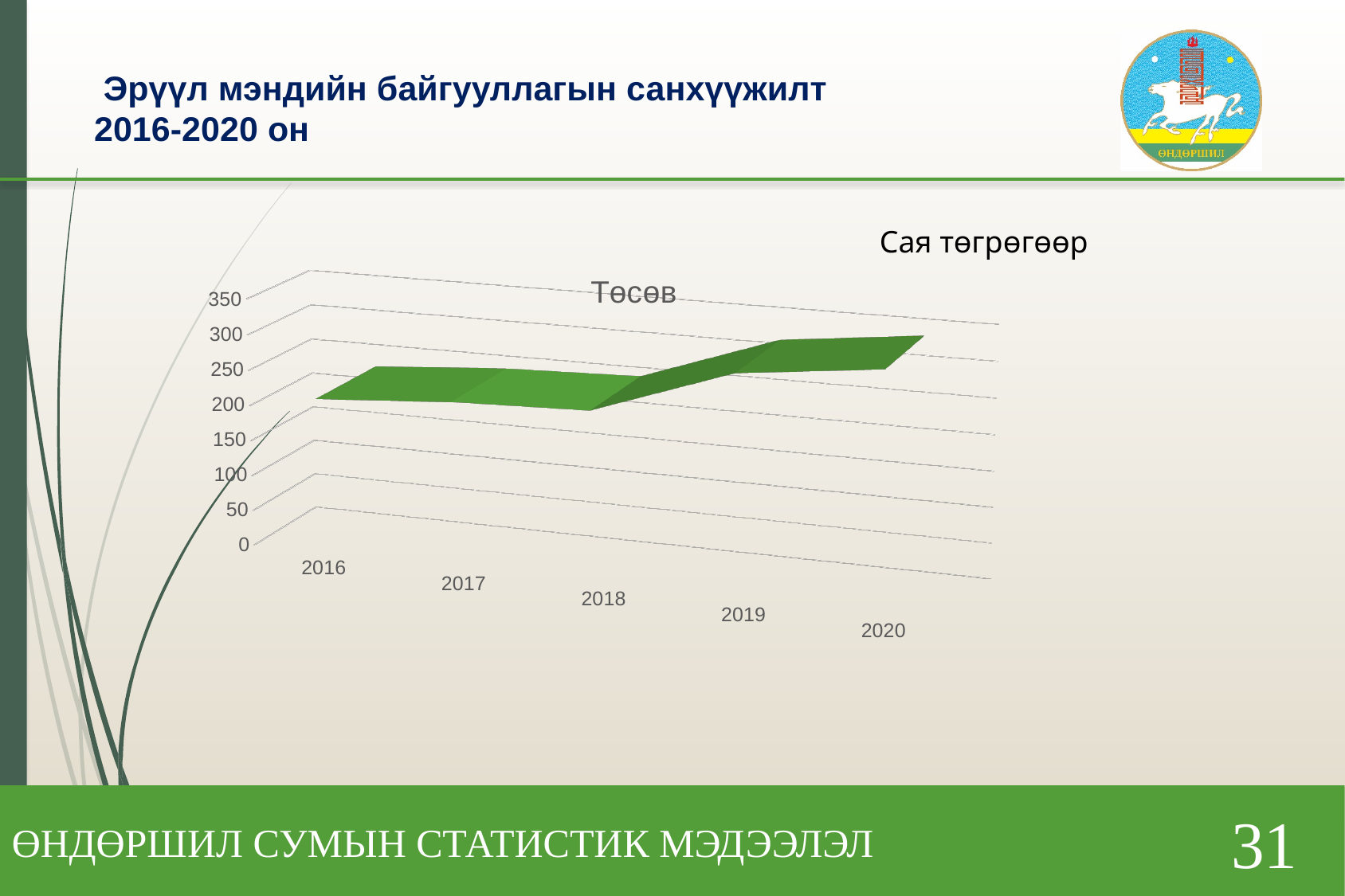
How many years are plotted on the x axis of the chart? 5 Is the value for 2016 greater or less than 300? less Is the value for 2019 greater or less than 350? less What is the title of the chart? Төсөв Overall, do the values rise or fall from 2016 to 2020? rise Is the value for 2020 greater or less than 150? greater Which is larger, the value for 2019 or the value for 2017? 2019 Which is larger, the value for 2020 or the value for 2016? 2020 Does the value rise or fall from 2018 to 2019? rise What kind of chart is shown on the slide? line chart Which years does the chart cover? 2016 to 2020